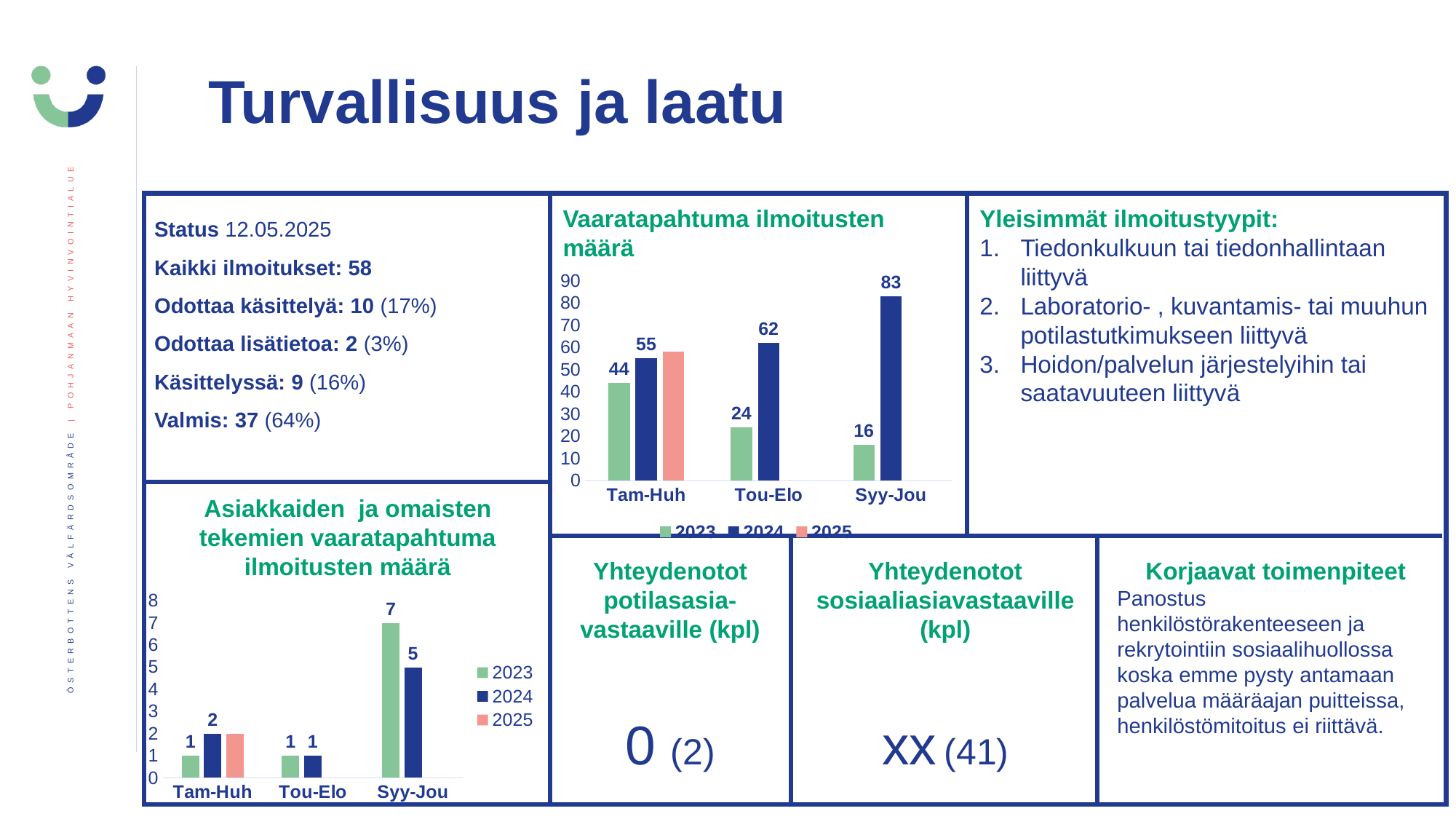
In the chart 'Asiakkaiden ja omaisten tekemien vaaratapahtuma ilmoitusten määrä', which is larger in Syy-Jou, the 2023 value or the 2024 value? 2023 In the chart 'Vaaratapahtuma ilmoitusten määrä', what is the value for 2024 in Syy-Jou? 83 In the chart 'Vaaratapahtuma ilmoitusten määrä', what is the difference between the 2024 and 2023 values in Tam-Huh? 11 In the chart 'Vaaratapahtuma ilmoitusten määrä', which category has the highest 2024 value? Syy-Jou In the chart 'Asiakkaiden ja omaisten tekemien vaaratapahtuma ilmoitusten määrä', what is the value for 2023 in Syy-Jou? 7 In the chart 'Vaaratapahtuma ilmoitusten määrä', which category has the lowest 2023 value? Syy-Jou What kind of chart is 'Asiakkaiden ja omaisten tekemien vaaratapahtuma ilmoitusten määrä'? bar chart In the chart 'Vaaratapahtuma ilmoitusten määrä', what is the value for 2023 in Tou-Elo? 24 How many categories are shown on the x axis of the chart 'Asiakkaiden ja omaisten tekemien vaaratapahtuma ilmoitusten määrä'? 3 How many series does the legend of the chart 'Vaaratapahtuma ilmoitusten määrä' list? 3 In the chart 'Vaaratapahtuma ilmoitusten määrä', is the 2025 value for Tam-Huh greater or less than 50? greater In the chart 'Vaaratapahtuma ilmoitusten määrä', do the 2023 values rise or fall from Tam-Huh to Syy-Jou? fall